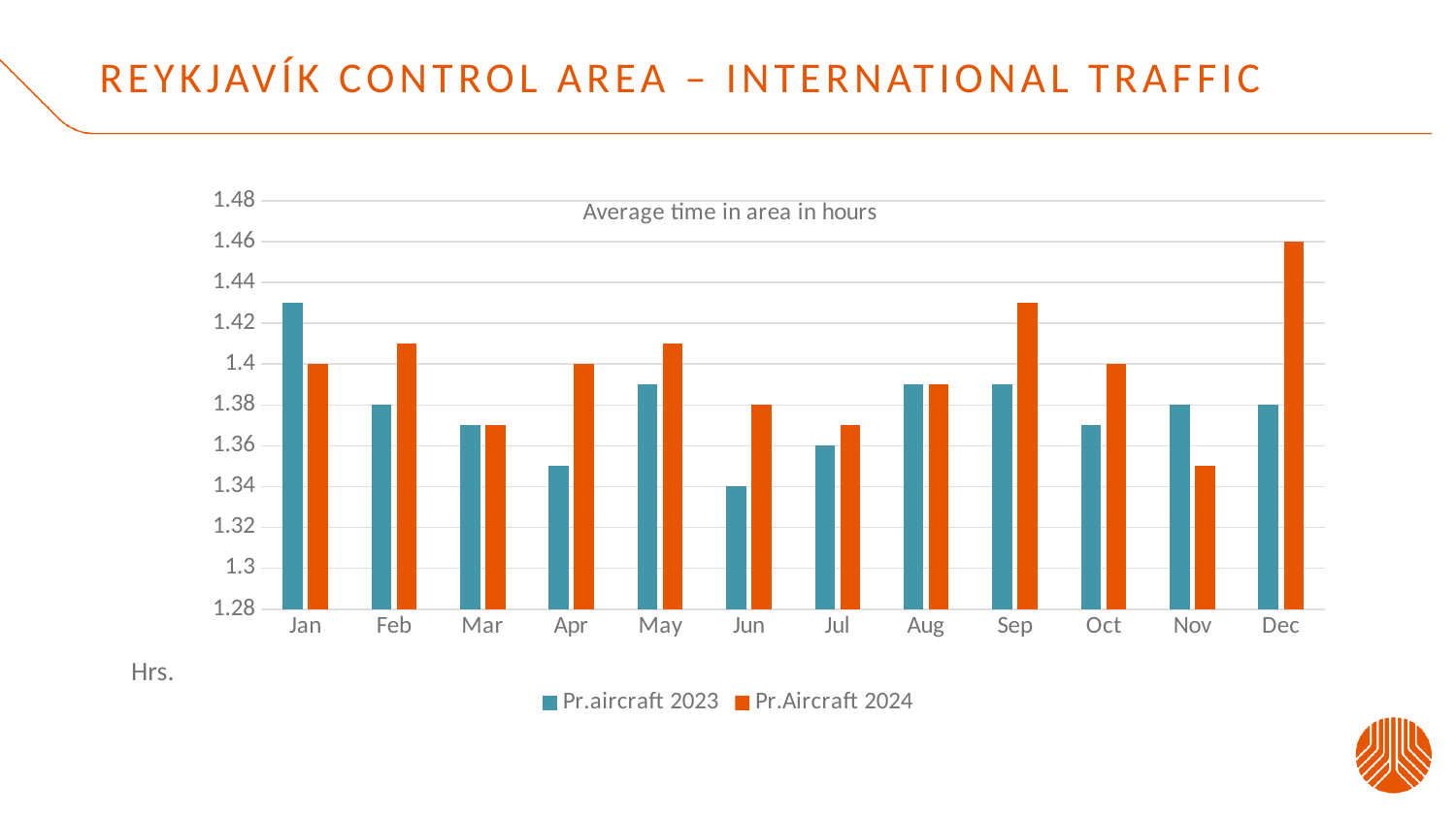
Is the value for Pr.aircraft 2023 in Jun greater or less than 1.36? less What kind of chart is shown on the slide? bar chart How many series does the legend list? 2 Which month has the highest value for Pr.aircraft 2023? Jan In Apr, which series has the larger value, Pr.aircraft 2023 or Pr.Aircraft 2024? Pr.Aircraft 2024 Is the value for Pr.Aircraft 2024 in Sep greater or less than 1.4? greater Is the value for Pr.Aircraft 2024 in Dec greater or less than 1.44? greater Which month has the highest value for Pr.Aircraft 2024? Dec In Jan, which series has the larger value, Pr.aircraft 2023 or Pr.Aircraft 2024? Pr.aircraft 2023 What is the title shown inside the chart area? Average time in area in hours How many months are shown on the x axis? 12 Which month has the lowest value for Pr.Aircraft 2024? Nov